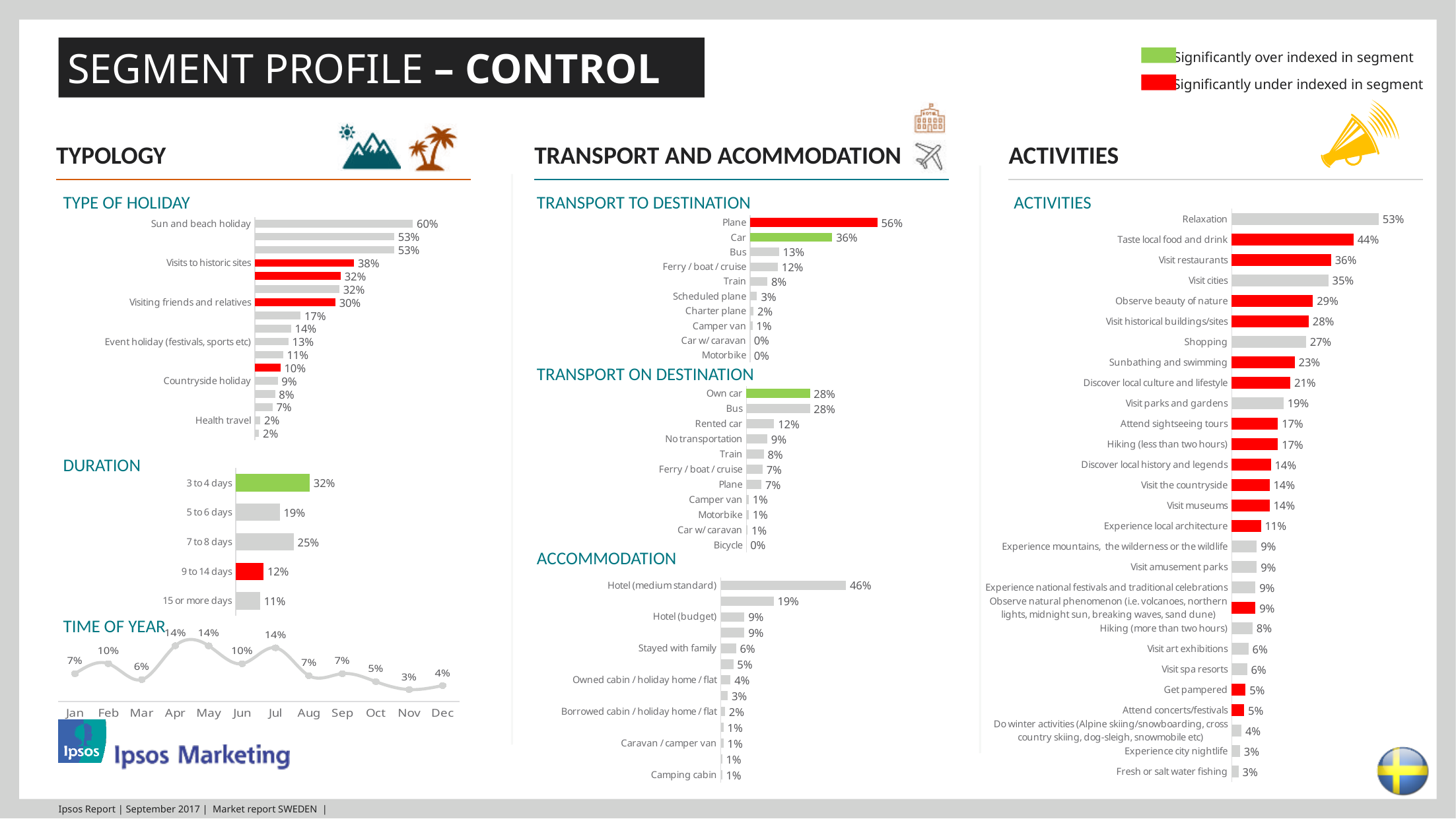
In the Type of Holiday chart, what is the value for Visits to historic sites? 38% In the Transport to Destination chart, what is the difference between Plane and Car? 20% In the Transport to Destination chart, what is the value for Plane? 56% In the Activities chart, which is larger: Visit restaurants or Shopping? Visit restaurants In the Accommodation chart, what is the value for Hotel (medium standard)? 46% In the Duration chart, which duration has the lowest value? 15 or more days In the Transport on Destination chart, how many categories are shown? 11 In the Activities chart, what is the value for Taste local food and drink? 44% What kind of chart is the Time of Year chart? Line chart In the Time of Year chart, what is the value for Nov? 3% In the Duration chart, what is the value for 3 to 4 days? 32% In the Activities chart, which activity has the highest value? Relaxation